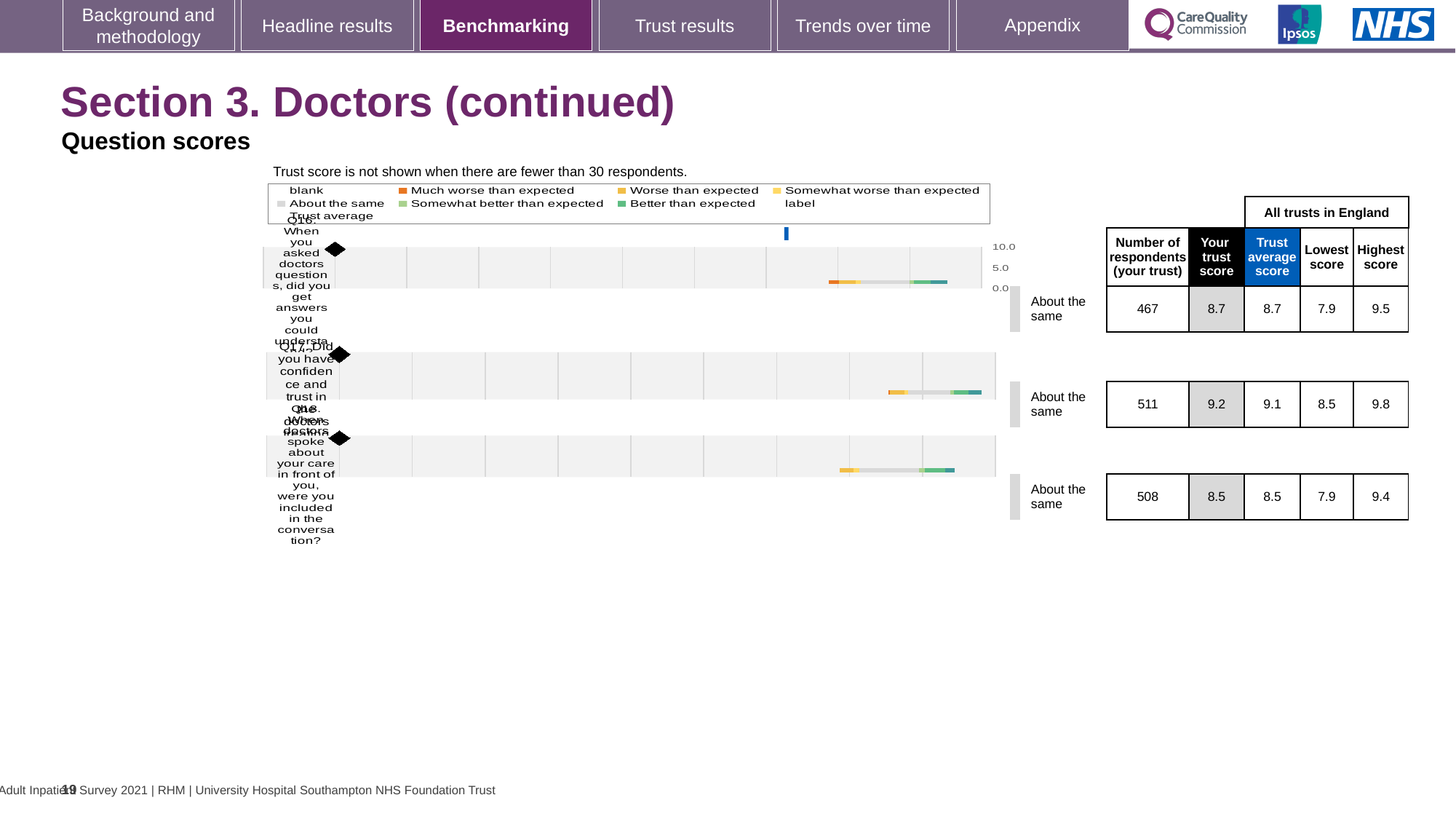
Which question has the lowest trust score? Q18 What benchmark category is shown for Q16? About the same For Q17, which is larger: the trust's own score or the trust average score? the trust's own score Which question has the highest trust score? Q17 What is the trust score for Q17 (Did you have confidence and trust in the doctors treating you)? 9.2 What kind of chart is used to show the question scores on this slide? bar chart What is the highest score across all trusts in England for Q18? 9.4 What is the difference between the highest score and the lowest score across all trusts in England for Q17? 1.3 How many respondents answered Q16 for this trust? 467 How many questions are plotted in the question scores chart? 3 What is the lowest score across all trusts in England for Q17? 8.5 What is the difference between the highest and lowest scores across all trusts in England for Q16? 1.6